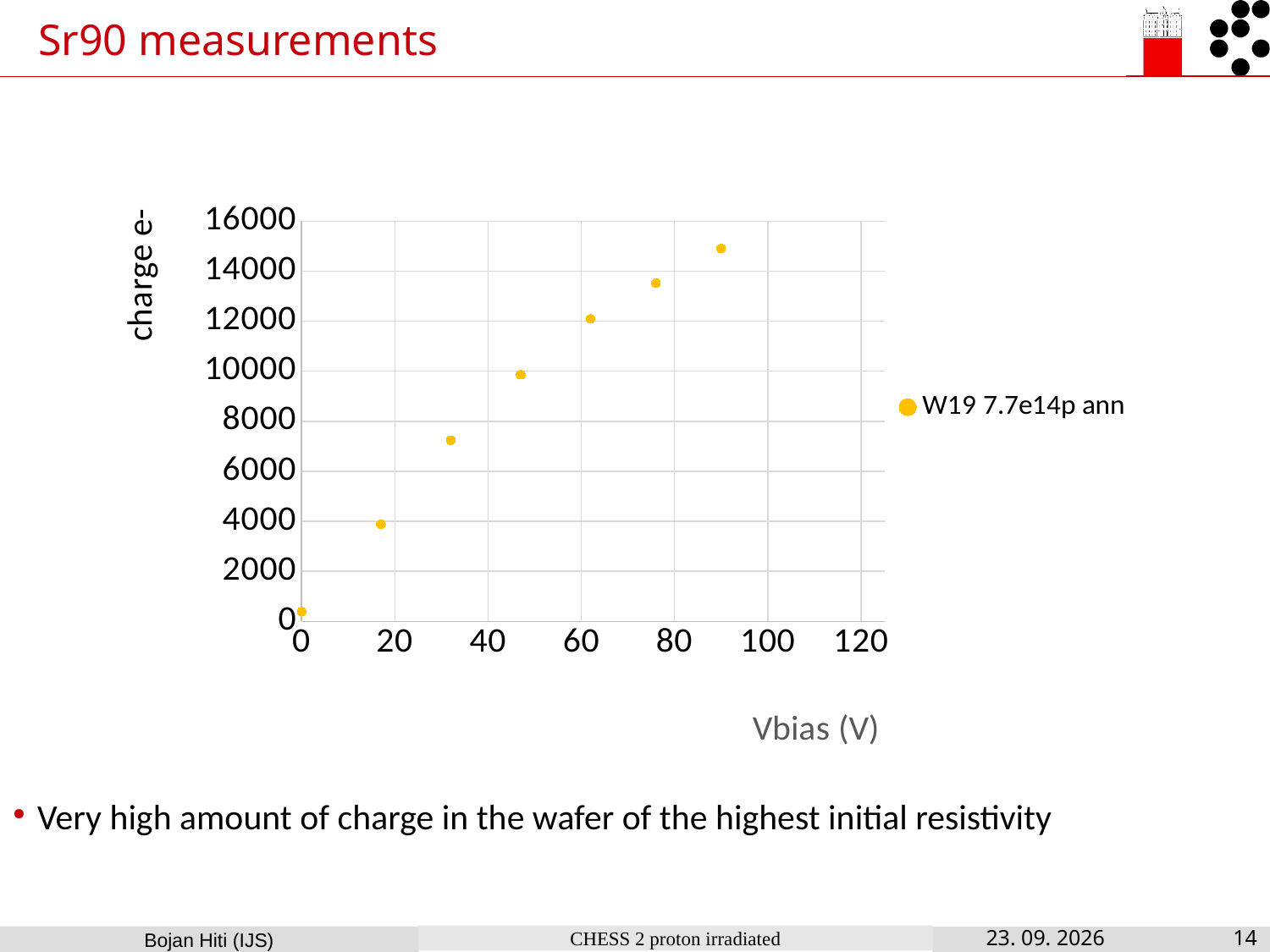
Is the charge value of the data point near 60 V greater or less than 10000? greater Is the charge value of the data point near 45 V greater or less than 8000? greater What is the name of the series shown in the legend? W19 7.7e14p ann Is the charge value of the data point near 30 V greater or less than 6000? greater How many data points are plotted in the chart? 7 How many series does the legend list? 1 Which data point has the lowest charge value, the one at 0 V or the one near 90 V? the one at 0 V Does the charge rise or fall as Vbias increases along the x axis? rise What kind of chart is shown on the slide? scatter chart What is the label of the x axis? Vbias (V)